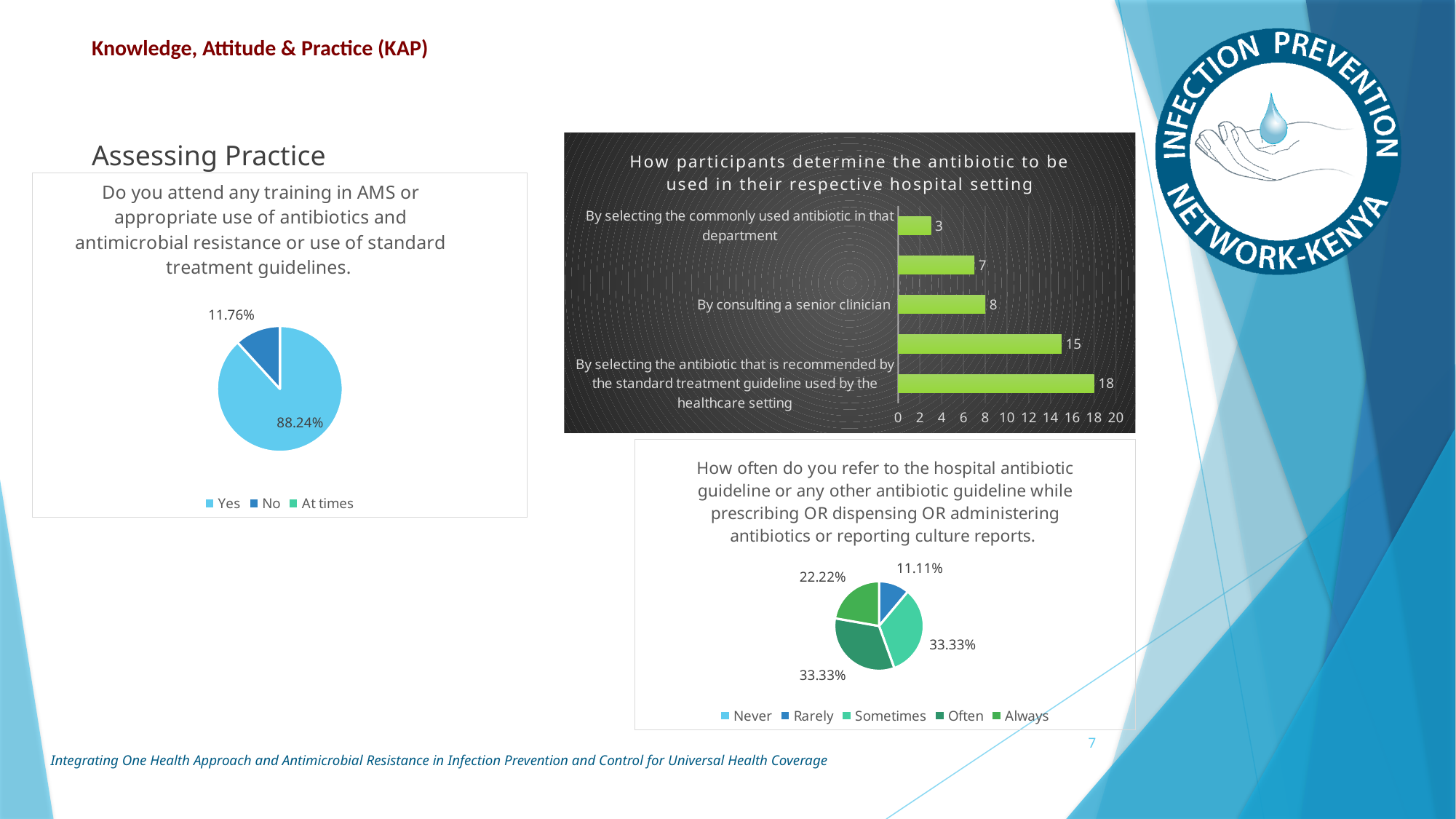
In the chart titled 'How participants determine the antibiotic to be used in their respective hospital setting', what is the value for 'By selecting the commonly used antibiotic in that department'? 3 In the pie chart titled 'How often do you refer to the hospital antibiotic guideline...', how many entries does the legend list? 5 In the chart titled 'How participants determine the antibiotic to be used in their respective hospital setting', what is the difference between the highest value and the lowest value? 15 In the chart titled 'How participants determine the antibiotic to be used in their respective hospital setting', which category has the highest value? By selecting the antibiotic that is recommended by the standard treatment guideline used by the healthcare setting In the pie chart titled 'Do you attend any training in AMS...', how many entries does the legend list? 3 In the chart titled 'How participants determine the antibiotic to be used in their respective hospital setting', how many bars are plotted? 5 In the pie chart titled 'Do you attend any training in AMS...', what percentage is shown for Yes? 88.24% In the pie chart titled 'How often do you refer to the hospital antibiotic guideline...', what percentage is shown for Always? 22.22% In the chart titled 'How participants determine the antibiotic to be used in their respective hospital setting', what kind of chart is used? Bar chart In the chart titled 'How participants determine the antibiotic to be used in their respective hospital setting', what is the value for 'By consulting a senior clinician'? 8 In the pie chart titled 'Do you attend any training in AMS...', what percentage is shown for No? 11.76% In the pie chart titled 'Do you attend any training in AMS...', what is the difference between the Yes and No percentages? 76.48%